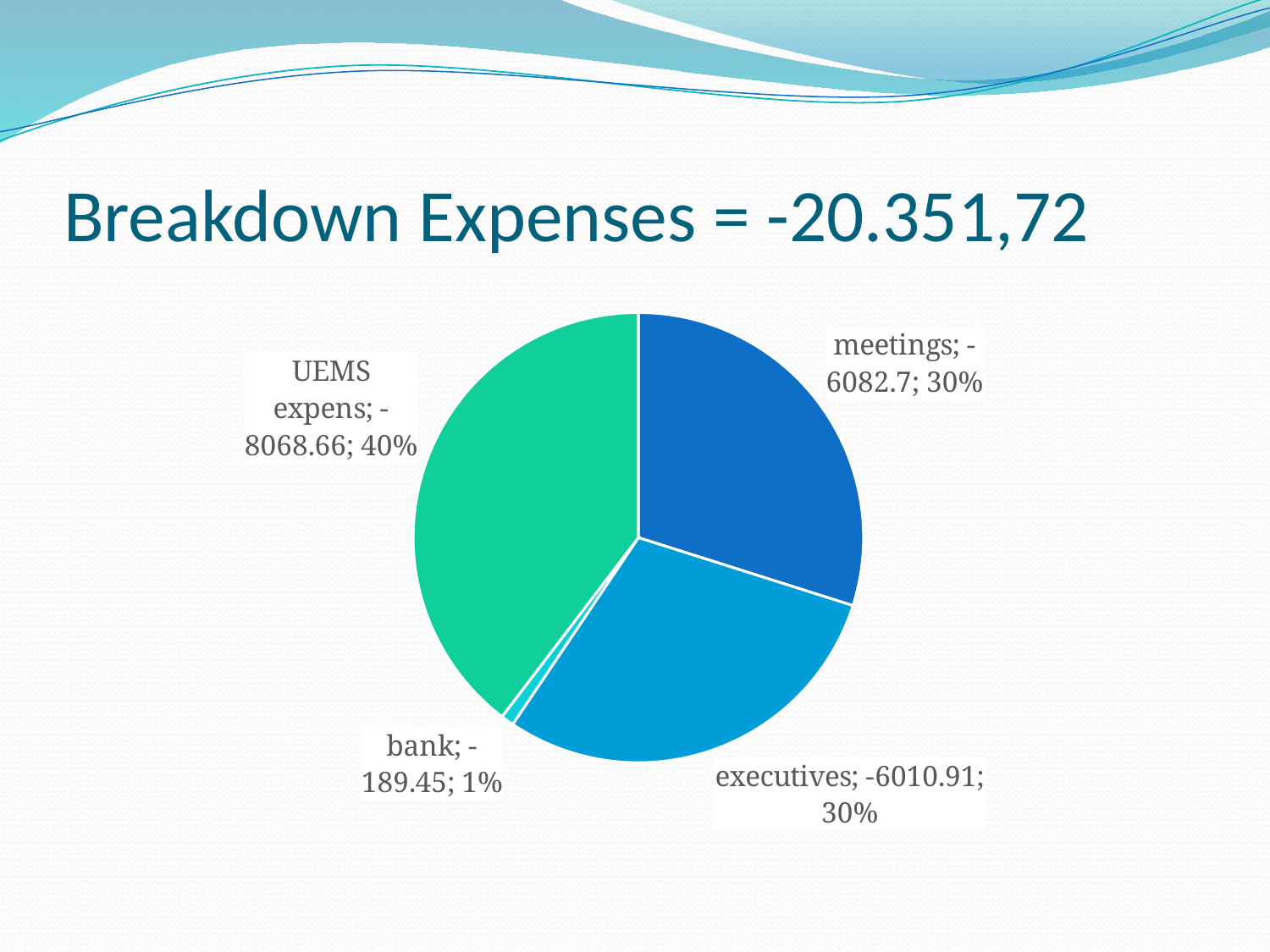
Which category has the largest share of the pie? UEMS expens What percentage share of the pie does the meetings slice have? 30% What percentage share of the pie does the UEMS expens slice have? 40% What value is shown for the bank slice? -189.45 Which category has the smallest share of the pie? bank What value is shown for the UEMS expens slice? -8068.66 What value is shown for the executives slice? -6010.91 What value is shown for the meetings slice of the pie chart? -6082.7 Which slice is larger, UEMS expens or executives? UEMS expens What is the difference in magnitude between the UEMS expens value (8068.66) and the meetings value (6082.7)? 1985.96 How many slices does the pie chart have? 4 What kind of chart is shown on the slide? pie chart